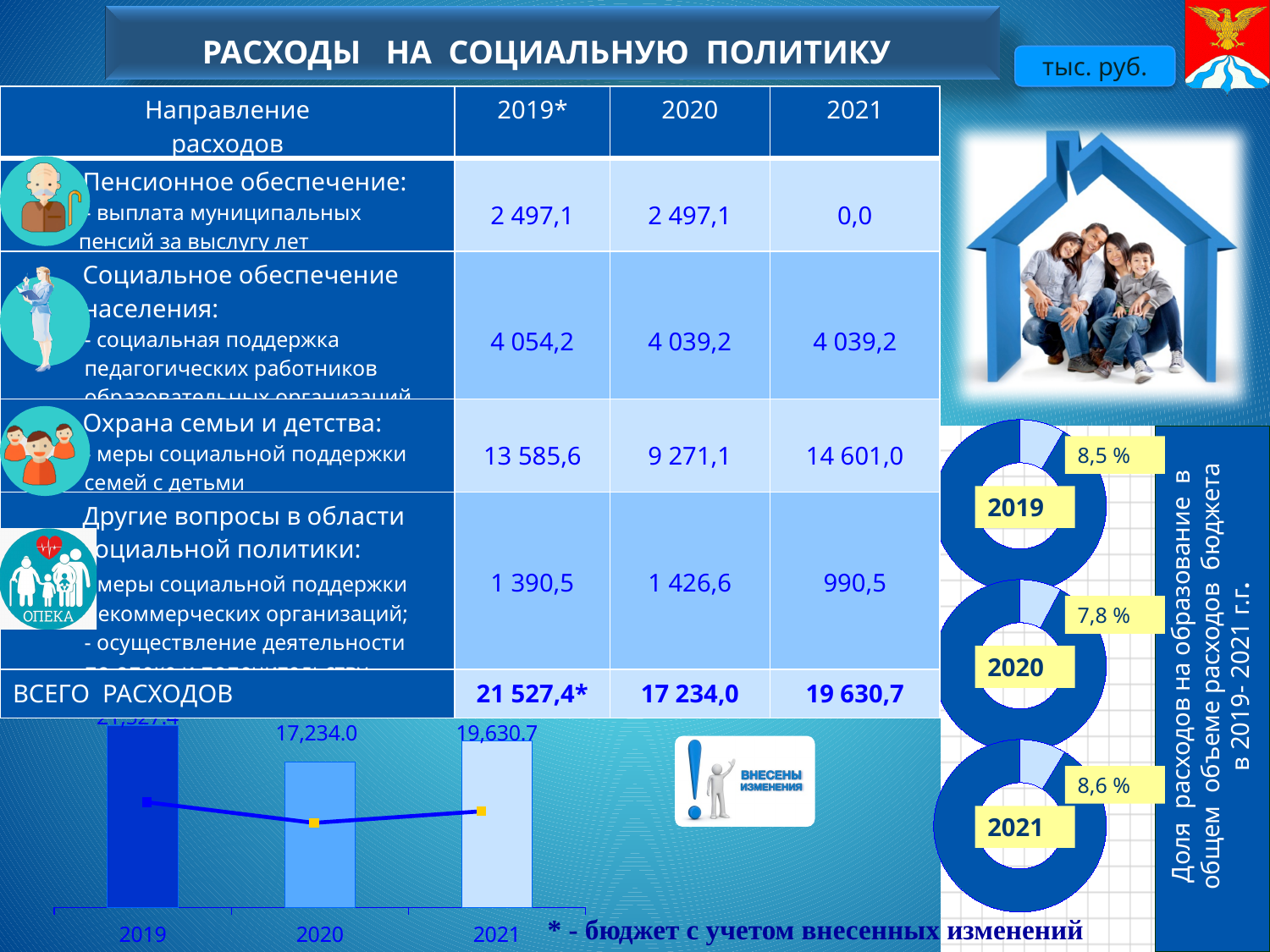
In the donut charts on the right, which year has the lowest share? 2020 In the bottom-left bar chart, which year has the tallest bar? 2019 In the bottom-left bar chart, what is the value shown for 2020? 17,234.0 In the bottom-left bar chart, which year has the shortest bar? 2020 In the donut charts on the right, what share is shown for 2020? 7,8 % How many bars are in the bottom-left bar chart? 3 What kind of chart is shown at the bottom left of the slide? bar chart In the bottom-left bar chart, what is the difference between the 2021 value and the 2020 value? 2,396.7 In the bottom-left bar chart, what is the value shown for 2021? 19,630.7 In the bottom-left bar chart, is the value for 2021 larger or smaller than the value for 2020? larger In the bottom-left bar chart, does the value rise or fall from 2020 to 2021? rise In the donut charts on the right, what share is shown for 2019? 8,5 %